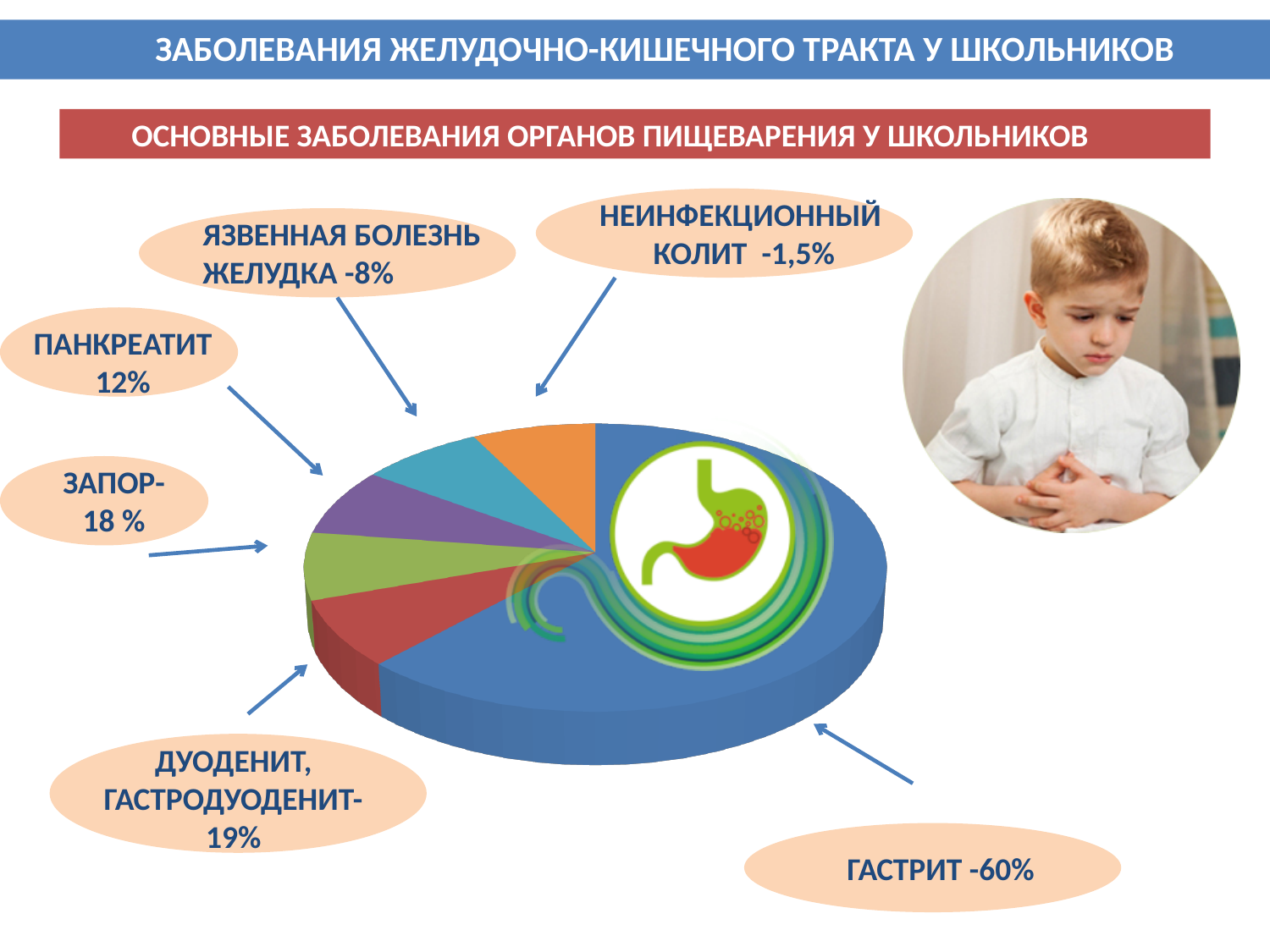
What is the difference between the values for Язвенная болезнь желудка and Неинфекционный колит? 6,5% Which disease category has the largest share of the pie chart? Гастрит Which disease category has the smallest share of the pie chart? Неинфекционный колит What is the value shown for Гастрит? 60% What is the title of the section containing the pie chart? ОСНОВНЫЕ ЗАБОЛЕВАНИЯ ОРГАНОВ ПИЩЕВАРЕНИЯ У ШКОЛЬНИКОВ What is the difference between the values for Гастрит and Дуоденит, гастродуоденит? 41% What is the value shown for Неинфекционный колит? 1,5% How many disease categories are labelled on the pie chart? 6 What kind of chart is shown on the slide? Pie chart What is the value shown for Дуоденит, гастродуоденит? 19% What is the value shown for Панкреатит? 12% Which is larger: the value for Запор or the value for Панкреатит? Запор